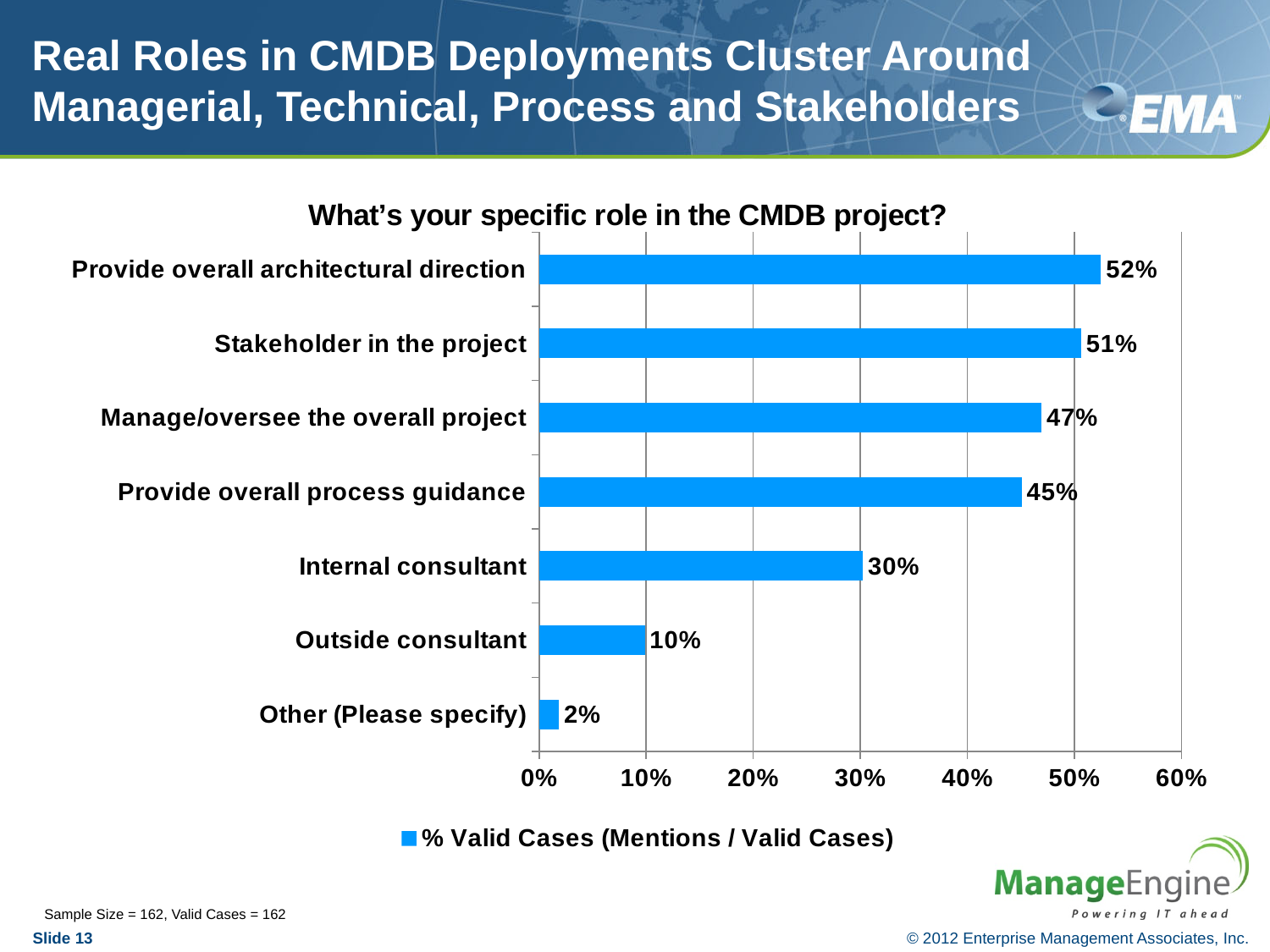
What type of chart is shown on the slide? Bar chart What is the difference between 'Internal consultant' and 'Outside consultant'? 20% What is the value for 'Internal consultant'? 30% What is the difference between 'Manage/oversee the overall project' and 'Provide overall process guidance'? 2% How many roles are shown in the chart? 7 What is the legend entry for the series shown in the chart? % Valid Cases (Mentions / Valid Cases) Which role has the highest percentage? Provide overall architectural direction What percentage of respondents said their role is to provide overall architectural direction? 52% Which is larger: 'Stakeholder in the project' or 'Internal consultant'? Stakeholder in the project Which role has the lowest percentage? Other (Please specify) What is the value for 'Outside consultant'? 10% Is the value for 'Provide overall process guidance' greater or less than 40%? greater